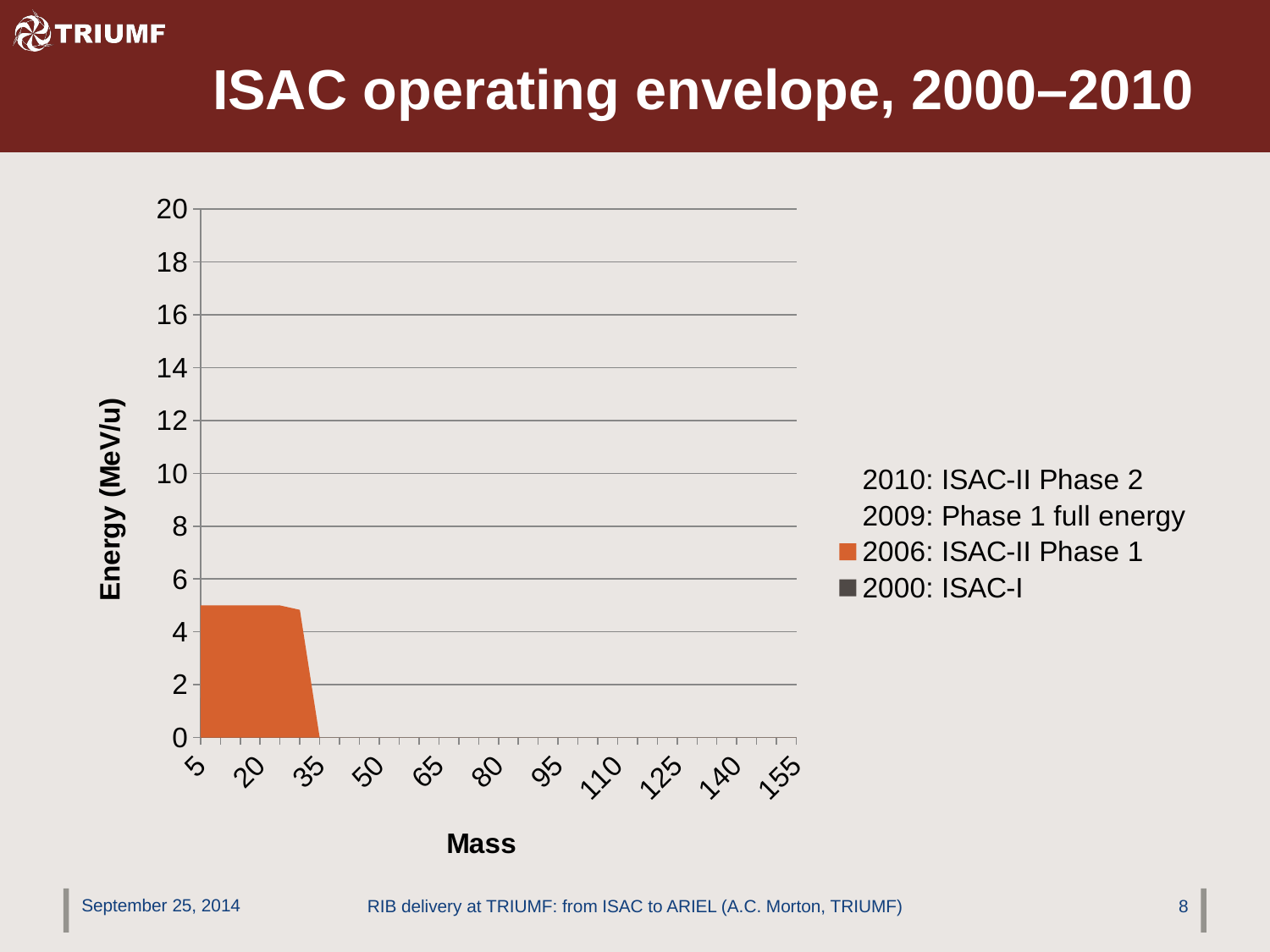
Is the energy value for the 2006: ISAC-II Phase 1 series at mass 20 greater or less than 6? less Which legend entry is shown in orange? 2006: ISAC-II Phase 1 What is the lowest mass value labelled on the x axis? 5 What is the highest value shown on the y axis? 20 Does the plotted energy for the 2006: ISAC-II Phase 1 series rise or fall as mass increases from 20 to 35? fall How many mass values are labelled on the x axis? 11 What is the title of the x axis? Mass What kind of chart is shown on the slide? area chart How many series does the legend list? 4 Is the energy value for the 2006: ISAC-II Phase 1 series at mass 20 greater or less than 4? greater